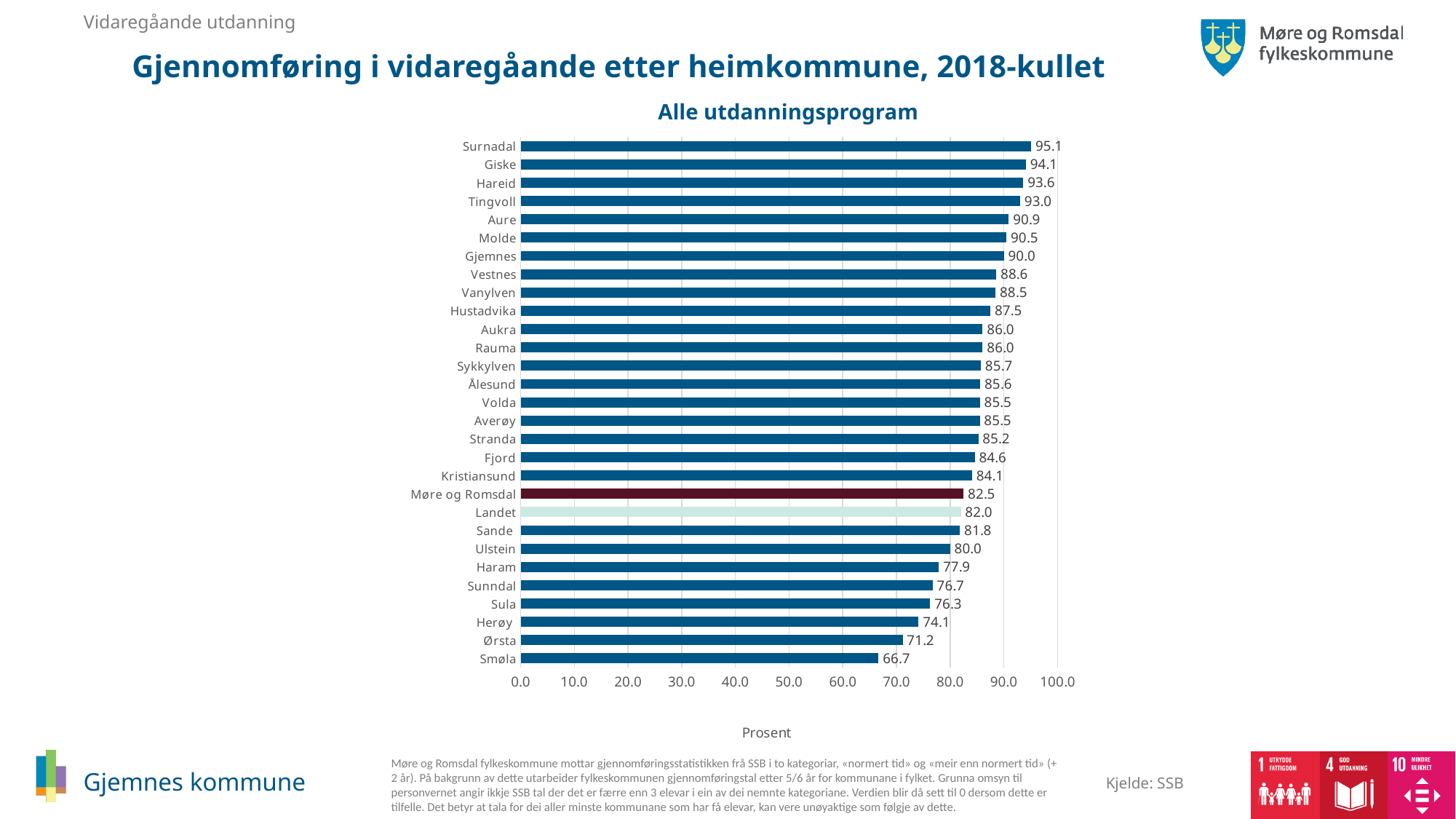
What is the value for Landet? 82.0 What is the value for Gjemnes? 90.0 What kind of chart is shown on the slide? bar chart Which municipality has the highest value? Surnadal What is the value for Møre og Romsdal? 82.5 What is the difference between the values for Surnadal and Smøla? 28.4 Which municipality has the lowest value? Smøla Which has a larger value, Molde or Kristiansund? Molde How many bars are shown in the chart? 29 What is the difference between the values for Gjemnes and Møre og Romsdal? 7.5 What is the title of the chart? Alle utdanningsprogram Is the value for Ørsta greater or less than 80.0? less